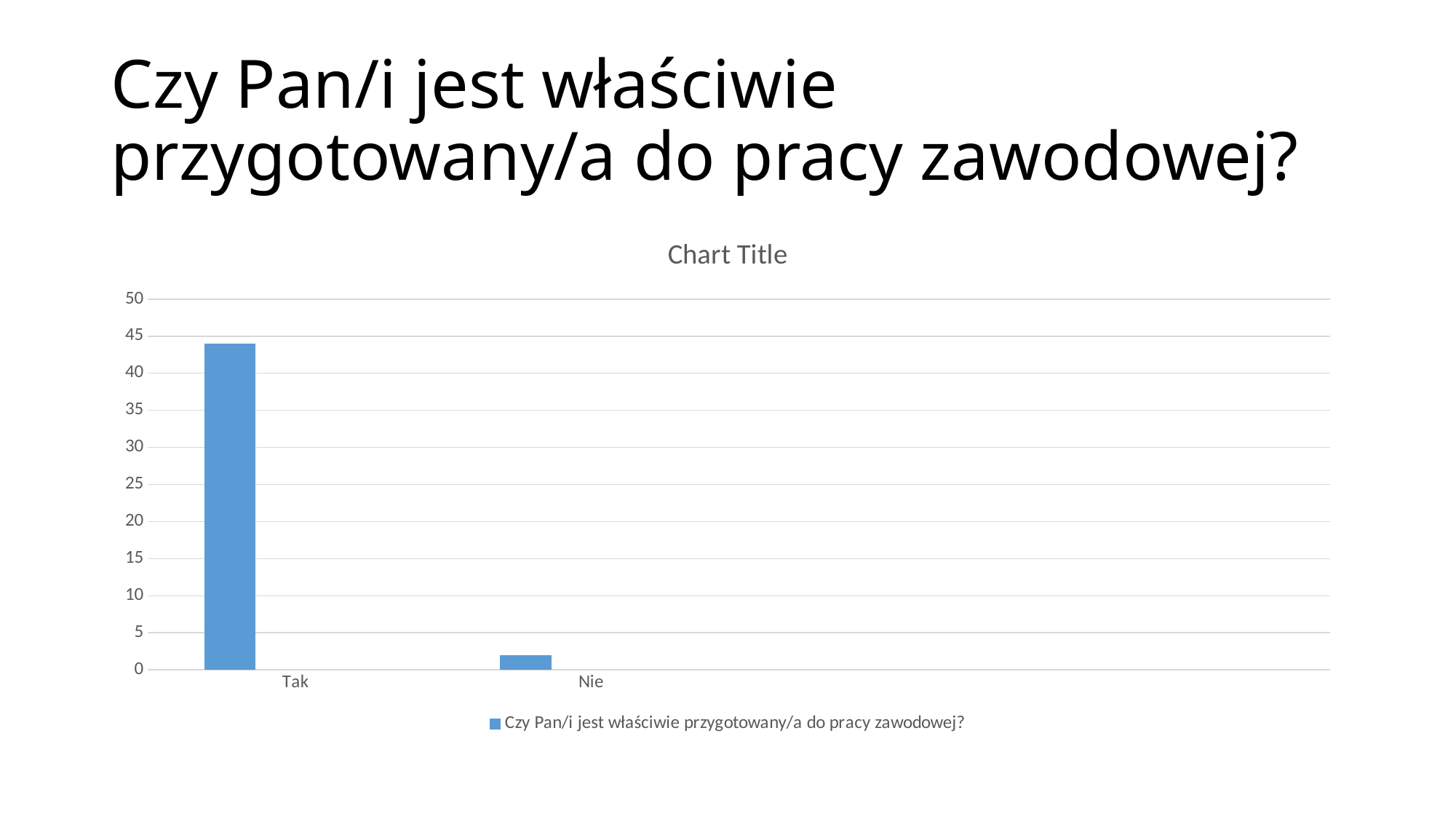
How many series does the chart's legend list? 1 What is the title shown above the chart? Chart Title Is the value for Nie greater or less than 5? less Which category has the highest value in the chart? Tak Is the value for Tak greater or less than 40? greater Do the values rise or fall from Tak to Nie along the x axis? fall Which category has the lowest value in the chart? Nie What kind of chart is shown on the slide? bar chart How many categories are shown on the x axis of the chart? 2 What series name is shown in the chart's legend? Czy Pan/i jest właściwie przygotowany/a do pracy zawodowej? Which is larger, the value for Tak or the value for Nie? Tak